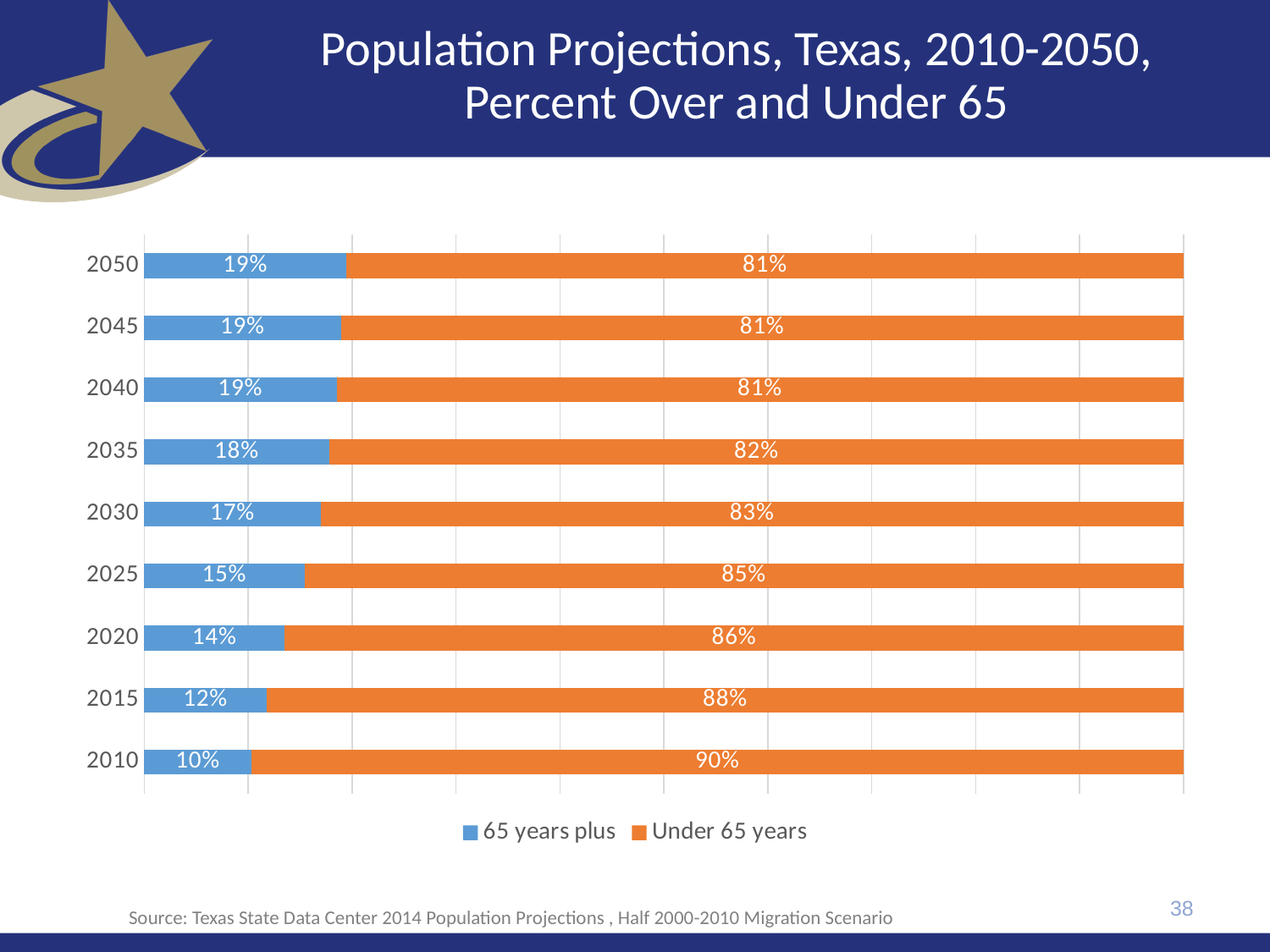
What kind of chart is shown on the slide? Stacked bar chart What percentage of the Texas population is projected to be 65 years plus in 2030? 17% Which is larger: the 65 years plus share in 2025 or in 2015? 2025 Which year has the highest share of population under 65 years? 2010 What is the total of the stacked bar for 2035? 100% What is the value for 65 years plus in 2020? 14% How many years are shown on the chart? 9 Does the 65 years plus share rise or fall from 2010 to 2050? Rise How many series does the legend list? 2 What is the difference between the 65 years plus share in 2050 and in 2010? 9 percentage points Which year has the lowest share of population aged 65 years plus? 2010 What percentage of the Texas population was under 65 years in 2010? 90%